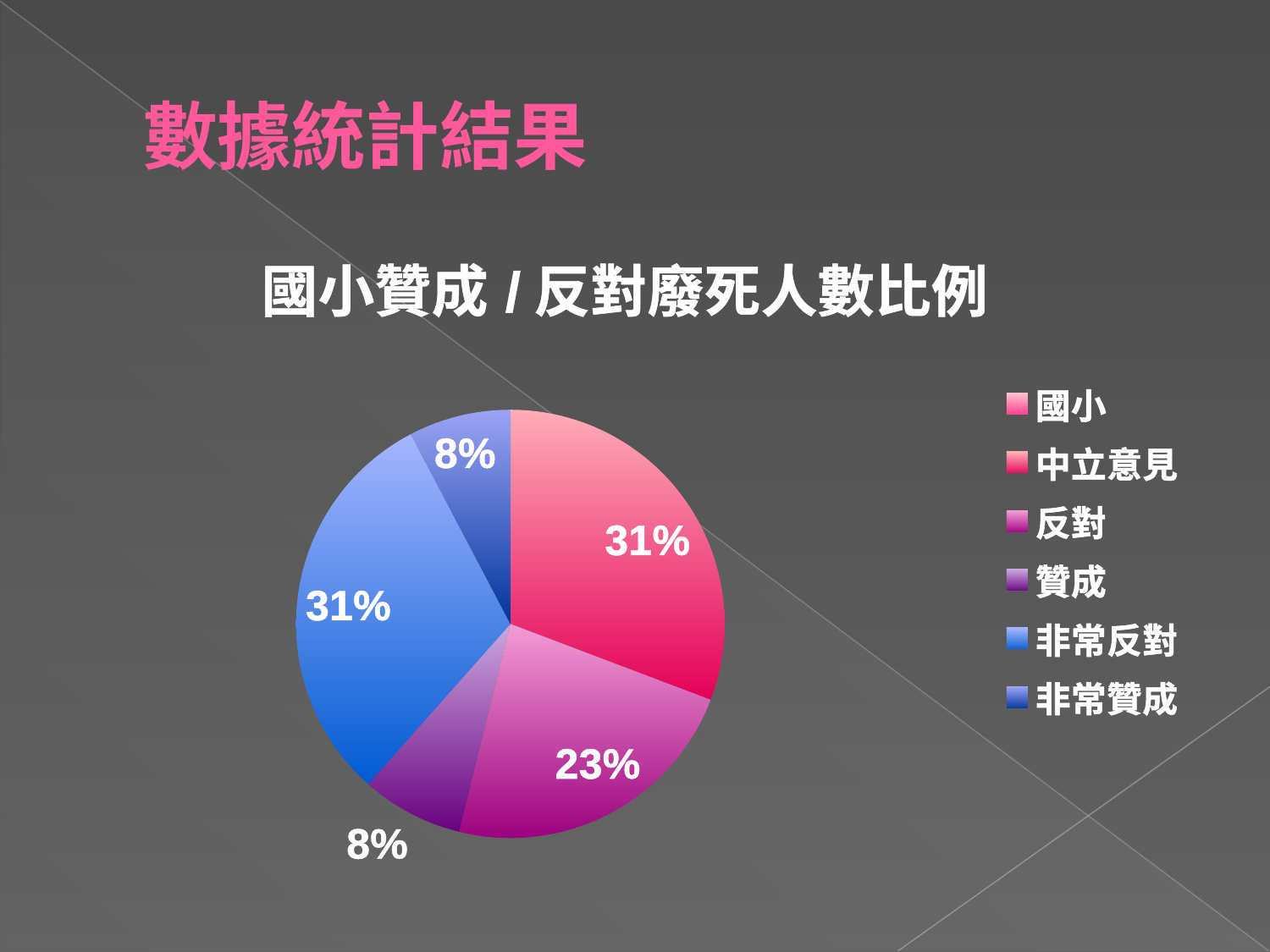
By how many percentage points does the 非常反對 slice exceed the 反對 slice? 8 What percentage is shown for the 非常反對 slice of the pie chart? 31% Which slice is larger in the pie chart, 非常反對 or 反對? 非常反對 What percentage label is on the large slice at the top right of the pie chart? 31% What percentage is shown for the 贊成 slice of the pie chart? 8% How many labelled slices are visible in the pie chart? 5 What kind of chart is shown on the slide? pie chart Which legend entry is listed first in the pie chart's legend? 國小 What is the title of the pie chart? 國小贊成 / 反對廢死人數比例 What percentage is shown for the 反對 slice of the pie chart? 23% What percentage is shown for the 非常贊成 slice of the pie chart? 8% How many entries does the legend of the pie chart list? 6